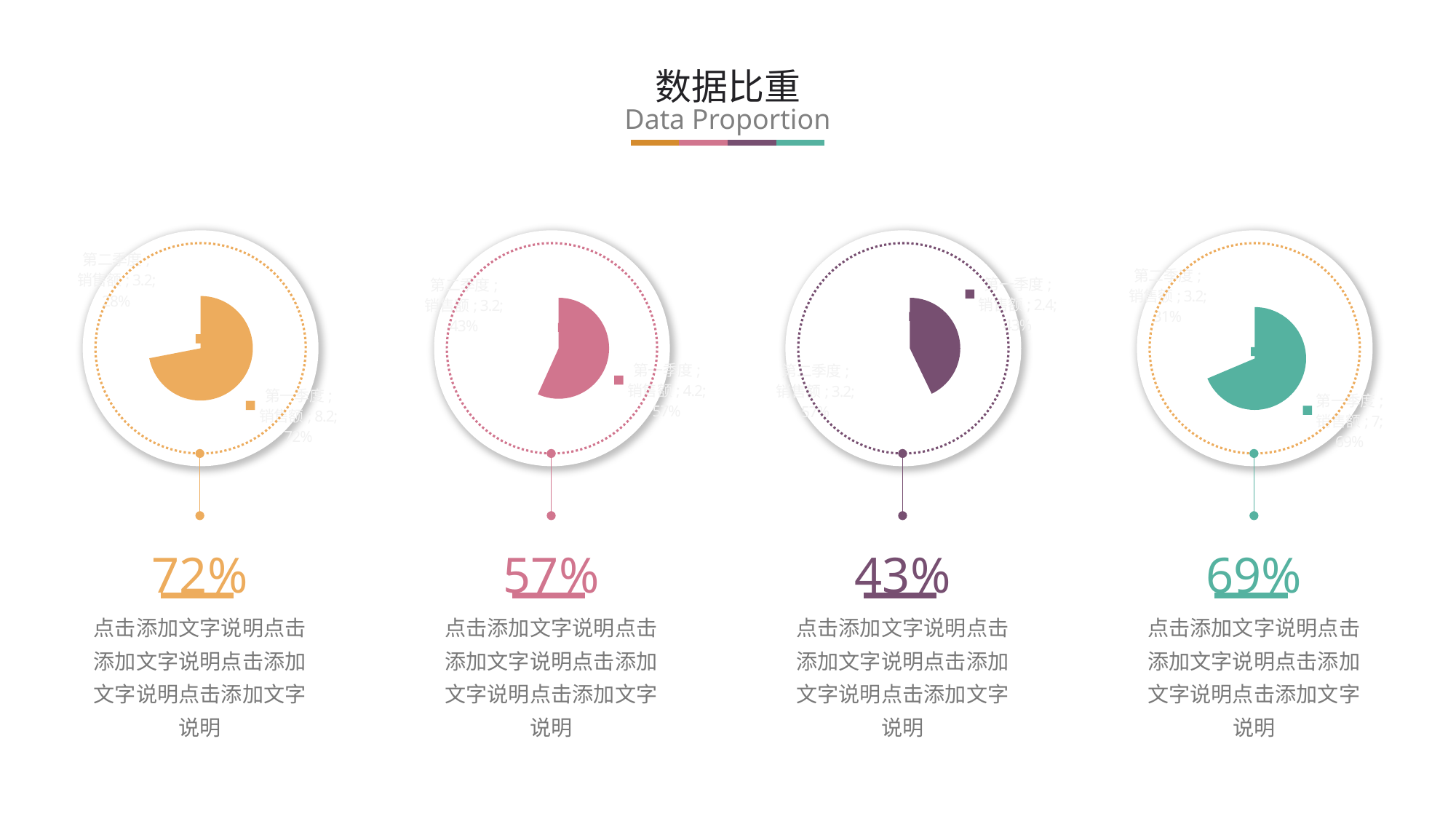
What colour is the highlighted slice in the third pie chart? Purple How many pie charts are on the slide? 4 What percentage is printed below the first (orange) pie chart on the left? 72% What is the difference between the percentage of the first (orange) chart and the third (purple) chart? 29 percentage points Which of the four pie charts shows the highest percentage? The first (orange) chart, 72% What percentage is printed below the fourth (teal) pie chart on the right? 69% Which of the four pie charts shows the lowest percentage? The third (purple) chart, 43% What percentage is printed below the third (purple) pie chart? 43% What percentage is printed below the second (pink) pie chart? 57% What is the English subtitle of the slide? Data Proportion Which is larger, the percentage of the second (pink) chart or the fourth (teal) chart? The fourth (teal) chart, 69% What kind of chart is shown inside each of the four circles on the slide? Pie chart